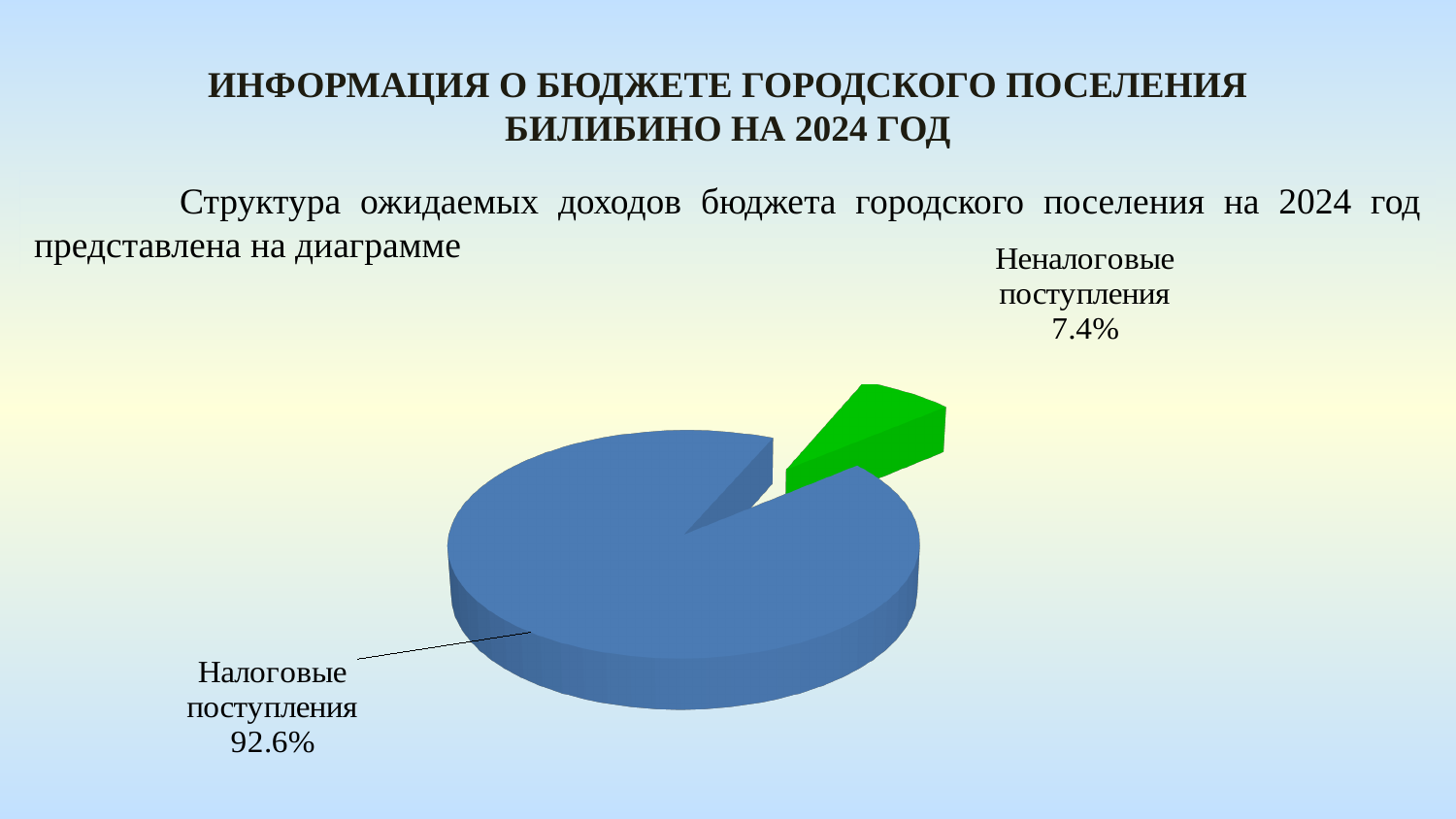
How many slices does the pie chart have? 2 What share of the pie is labelled Налоговые поступления? 92.6% What is the total of the two slice percentages shown? 100% What is the difference in percentage points between Налоговые поступления and Неналоговые поступления? 85.2 Which slice of the pie is the smallest? Неналоговые поступления What colour is the slice for Неналоговые поступления? Green Which is larger, Налоговые поступления or Неналоговые поступления? Налоговые поступления What share of the pie is labelled Неналоговые поступления? 7.4% What colour is the slice for Налоговые поступления? Blue Which slice of the pie is the largest? Налоговые поступления What kind of chart is shown on the slide? Pie chart